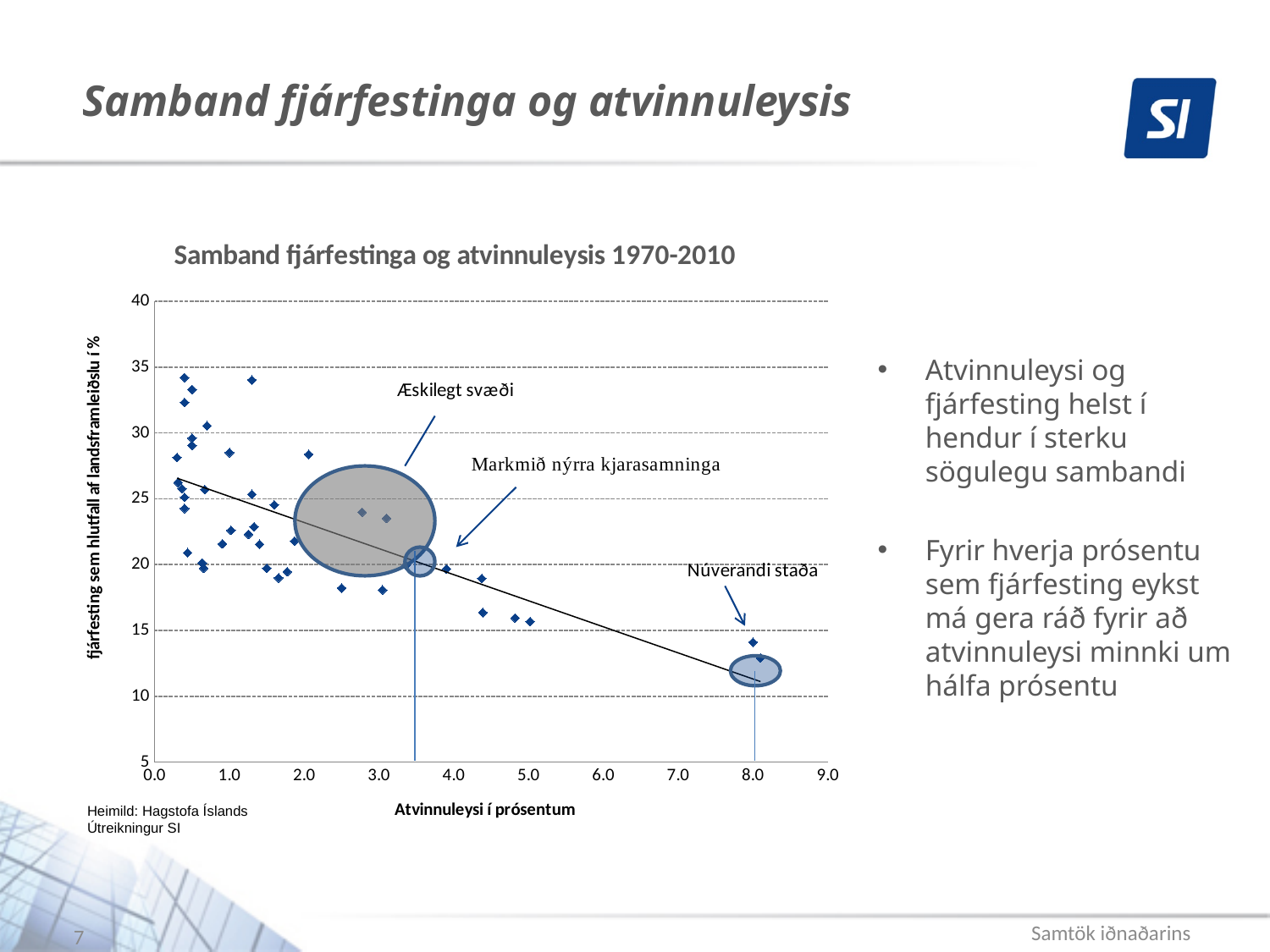
What is the title of the chart? Samband fjárfestinga og atvinnuleysis 1970-2010 What is the highest value shown on the y axis of the chart? 40 Is the investment value for the point marked "Núverandi staða" greater or less than 15? less Is the unemployment value at the point marked "Markmið nýrra kjarasamninga" greater or less than 3.0? greater Which has the higher investment value: the point marked "Markmið nýrra kjarasamninga" or the point marked "Núverandi staða"? Markmið nýrra kjarasamninga Is the investment value at the point marked "Markmið nýrra kjarasamninga" greater or less than 25? less What kind of chart is shown on the slide? scatter chart What is the label of the x axis of the chart? Atvinnuleysi í prósentum As unemployment (x axis) increases, does investment (y axis) rise or fall along the trend line? fall